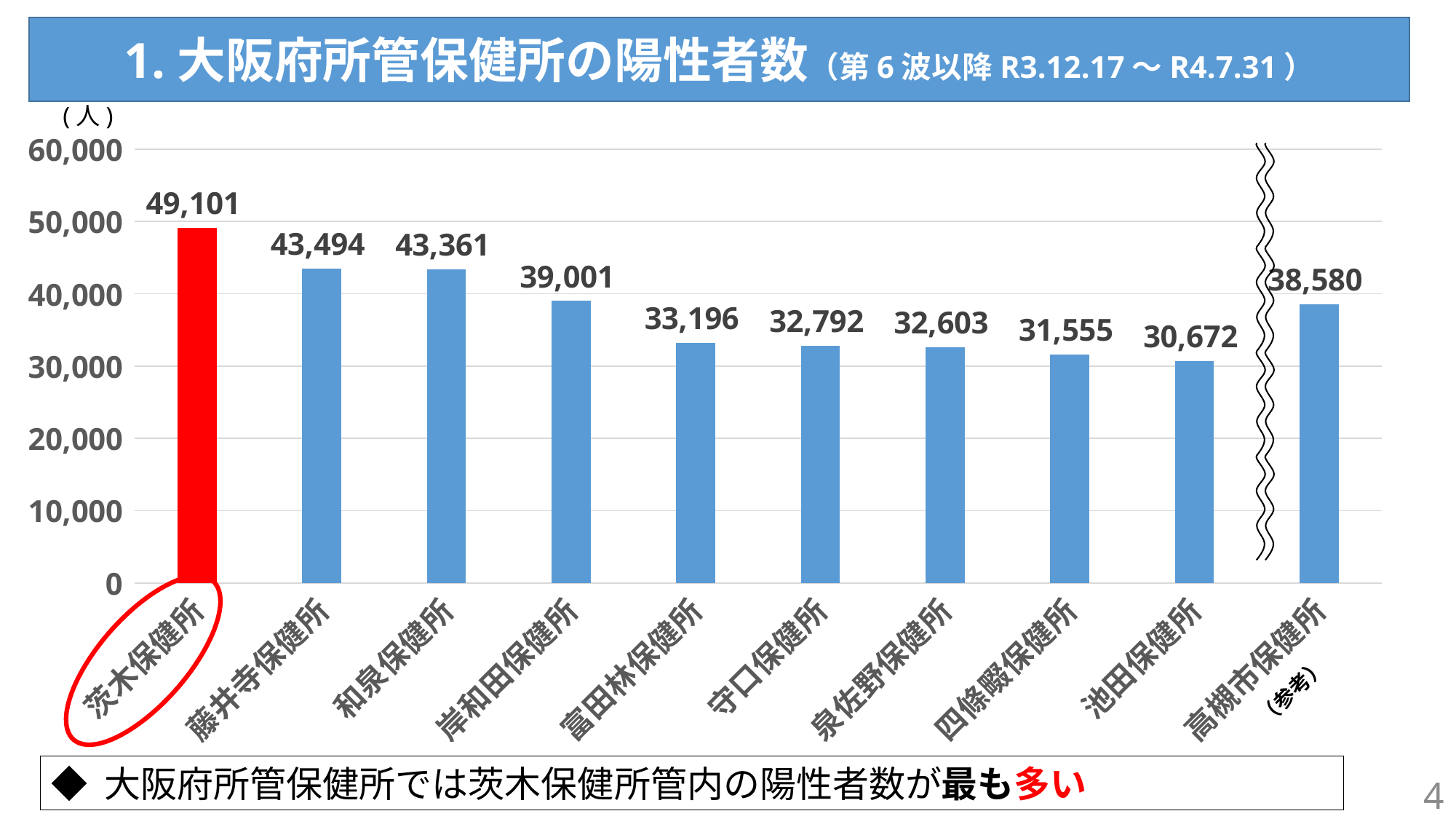
What is the number of positive cases for 茨木保健所? 49,101 What is the number of positive cases for 岸和田保健所? 39,001 Which has a larger value, 富田林保健所 or 守口保健所? 富田林保健所 What is the value shown for 高槻市保健所（参考）? 38,580 What is the difference between the values for 茨木保健所 and 藤井寺保健所? 5,607 Which health center has the lowest number of positive cases? 池田保健所 Is the value for 守口保健所 greater or less than 30,000? greater Which health center has the highest number of positive cases? 茨木保健所 What kind of chart is shown on the slide? bar chart How many health centers (bars) are shown in the chart? 10 What is the difference between the values for 藤井寺保健所 and 和泉保健所? 133 What is the value shown for 四條畷保健所? 31,555